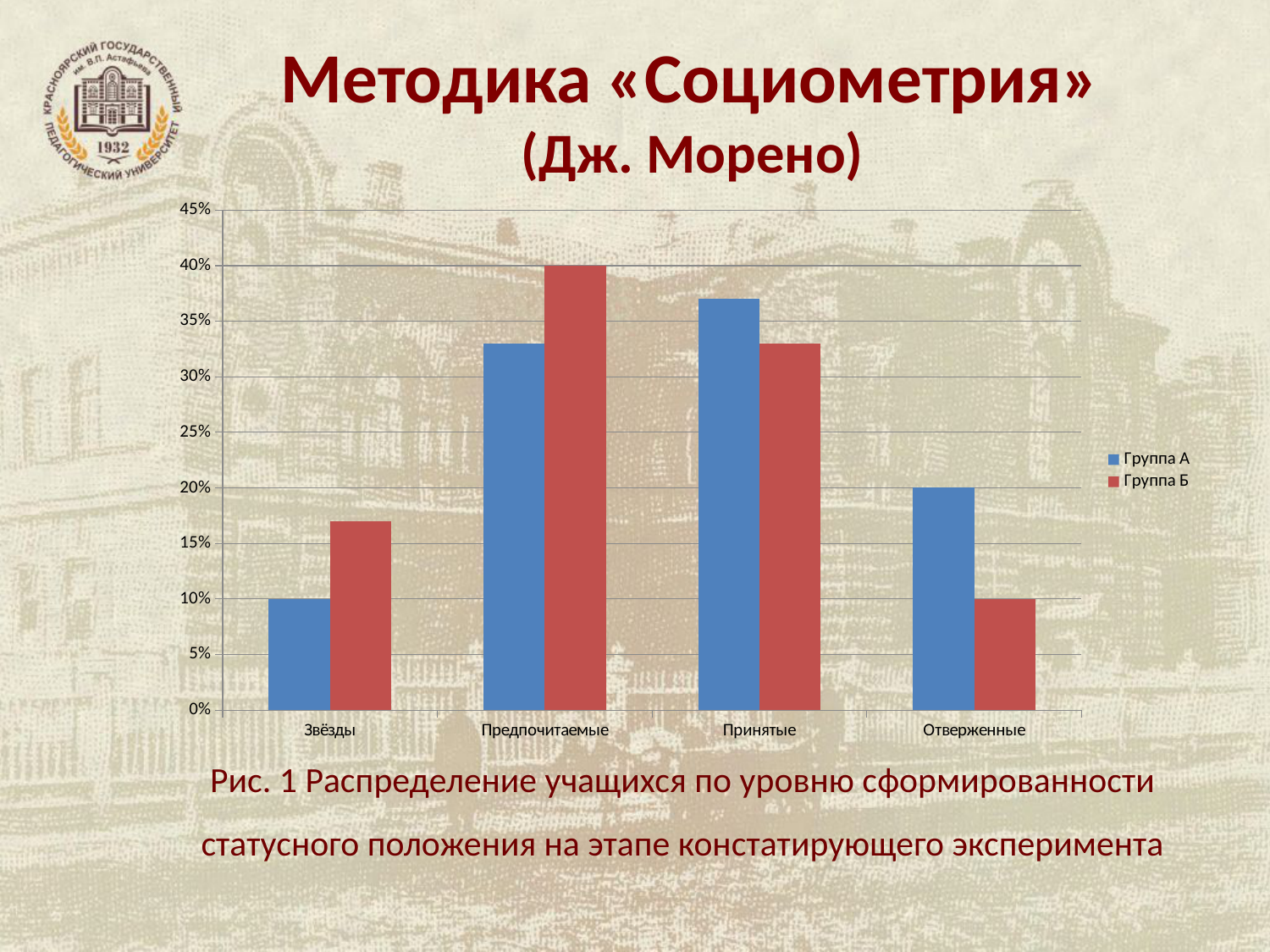
What is the value for Группа А in the Звёзды category? 10% Which category has the highest value for Группа Б? Предпочитаемые In the Принятые category, which group has the larger value, Группа А or Группа Б? Группа А What is the value for Группа Б in the Предпочитаемые category? 40% Which category has the lowest value for Группа А? Звёзды What is the value for Группа А in the Отверженные category? 20% What is the value for Группа Б in the Отверженные category? 10% How many categories are shown on the x axis of the chart? 4 What kind of chart is shown on the slide? Bar chart How many series does the chart legend list? 2 Is the value for Группа Б in the Звёзды category greater or less than 15%? greater What is the difference between Группа А and Группа Б in the Отверженные category? 10%